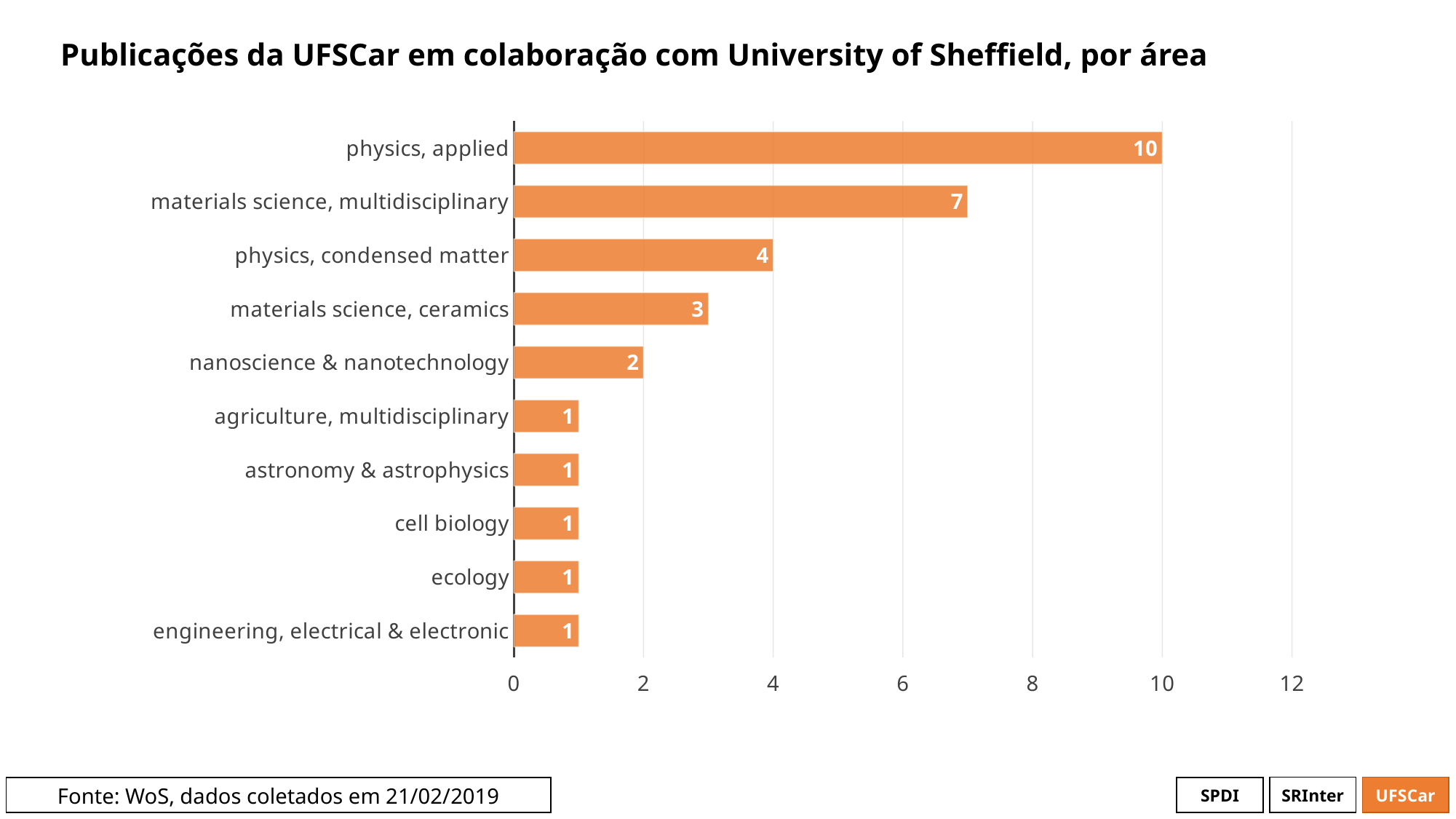
Which is larger, the value for materials science, ceramics or the value for nanoscience & nanotechnology? materials science, ceramics What kind of chart is shown on the slide? bar chart What is the value for physics, condensed matter? 4 How many areas are shown in the chart? 10 What is the value for physics, applied? 10 What is the difference between the values for physics, condensed matter and materials science, ceramics? 1 What is the value for materials science, multidisciplinary? 7 What is the difference between the values for physics, applied and materials science, multidisciplinary? 3 What is the value for nanoscience & nanotechnology? 2 What is the title of the chart? Publicações da UFSCar em colaboração com University of Sheffield, por área Which area has the highest number of publications? physics, applied Is the value for materials science, multidisciplinary greater or less than 6? greater